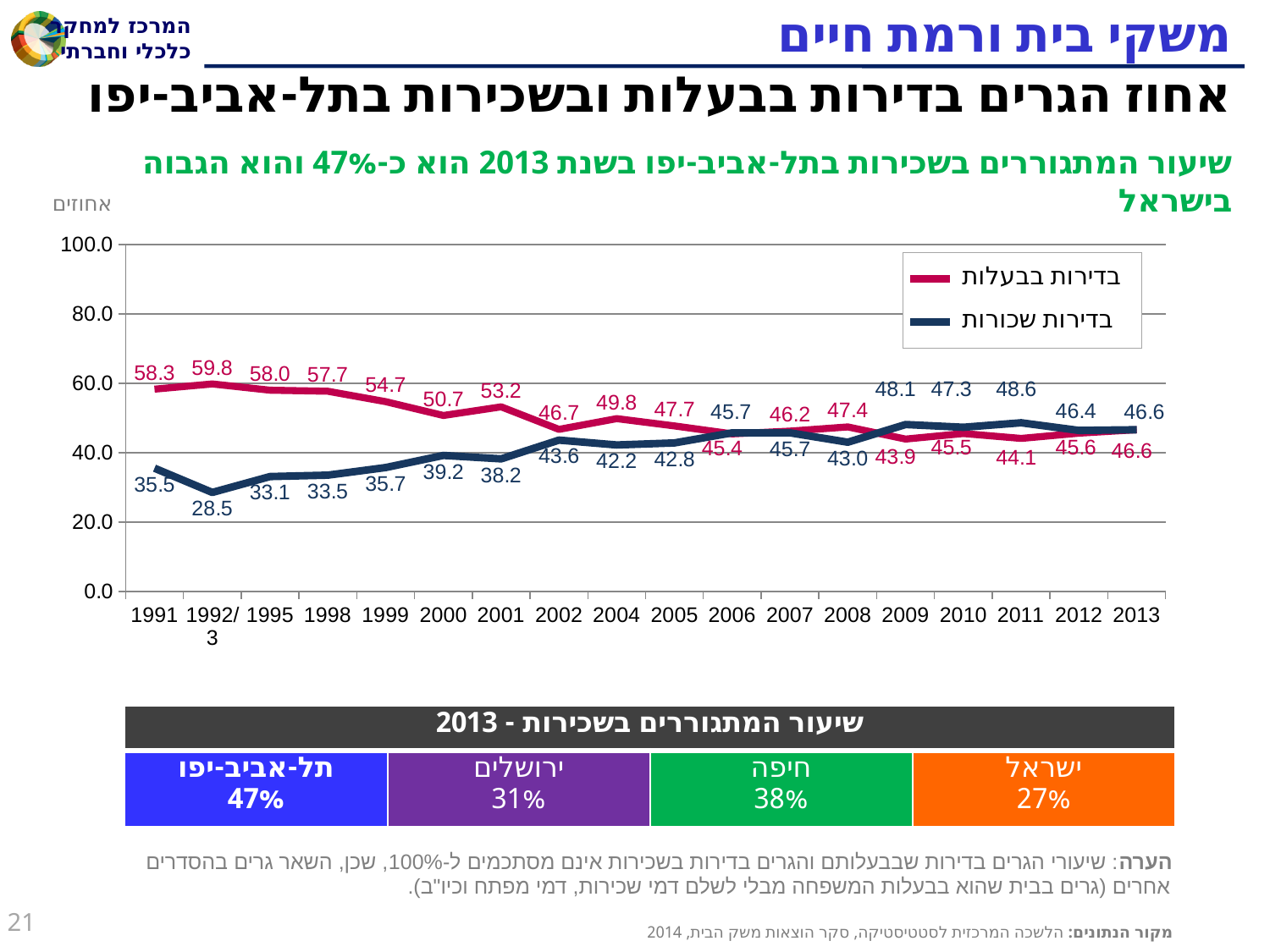
What is the value of both series in 2013? 46.6 Which series has the larger value in 2011, בדירות בבעלות or בדירות שכורות? בדירות שכורות In which year does the בדירות שכורות series reach its lowest value? 1992/3 What is the difference between the בדירות בבעלות and בדירות שכורות values in 1991? 22.8 What type of chart is shown on the slide? line chart What is the highest value of the בדירות שכורות series? 48.6 How many series does the chart legend list? 2 In which year does the בדירות בבעלות series reach its highest value? 1992/3 How many years are shown on the x axis of the chart? 18 What is the value of the בדירות שכורות series in 2000? 39.2 Does the בדירות בבעלות series generally rise or fall from 1991 to 2013? fall What is the value of the בדירות בבעלות series in 1991? 58.3